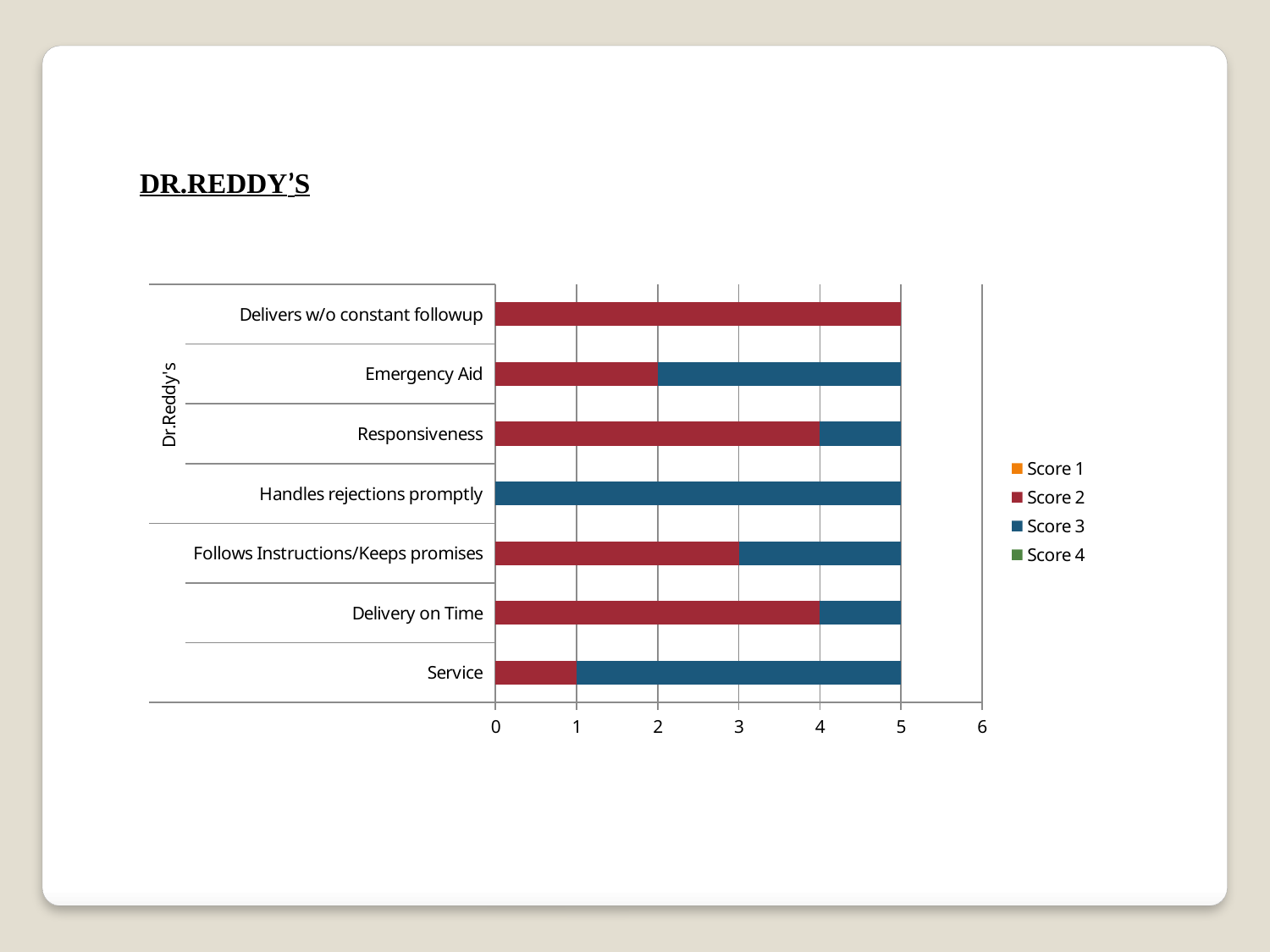
How many series does the legend list? 4 Which is larger, the Score 2 value for Delivery on Time or the Score 2 value for Service? Delivery on Time What is the difference between the Score 2 value for Responsiveness and the Score 2 value for Emergency Aid? 2 What is the label of the vertical axis group on the left of the chart? Dr.Reddy's What is the Score 3 value for Handles rejections promptly? 5 What is the Score 2 value for Service? 1 What kind of chart is shown on the slide? Stacked bar chart What is the Score 2 value for Emergency Aid? 2 What is the total of the stacked bar for Responsiveness? 5 How many categories are plotted on the chart? 7 Which category has the lowest Score 2 value among those with a Score 2 segment? Service What is the Score 2 value for Delivers w/o constant followup? 5